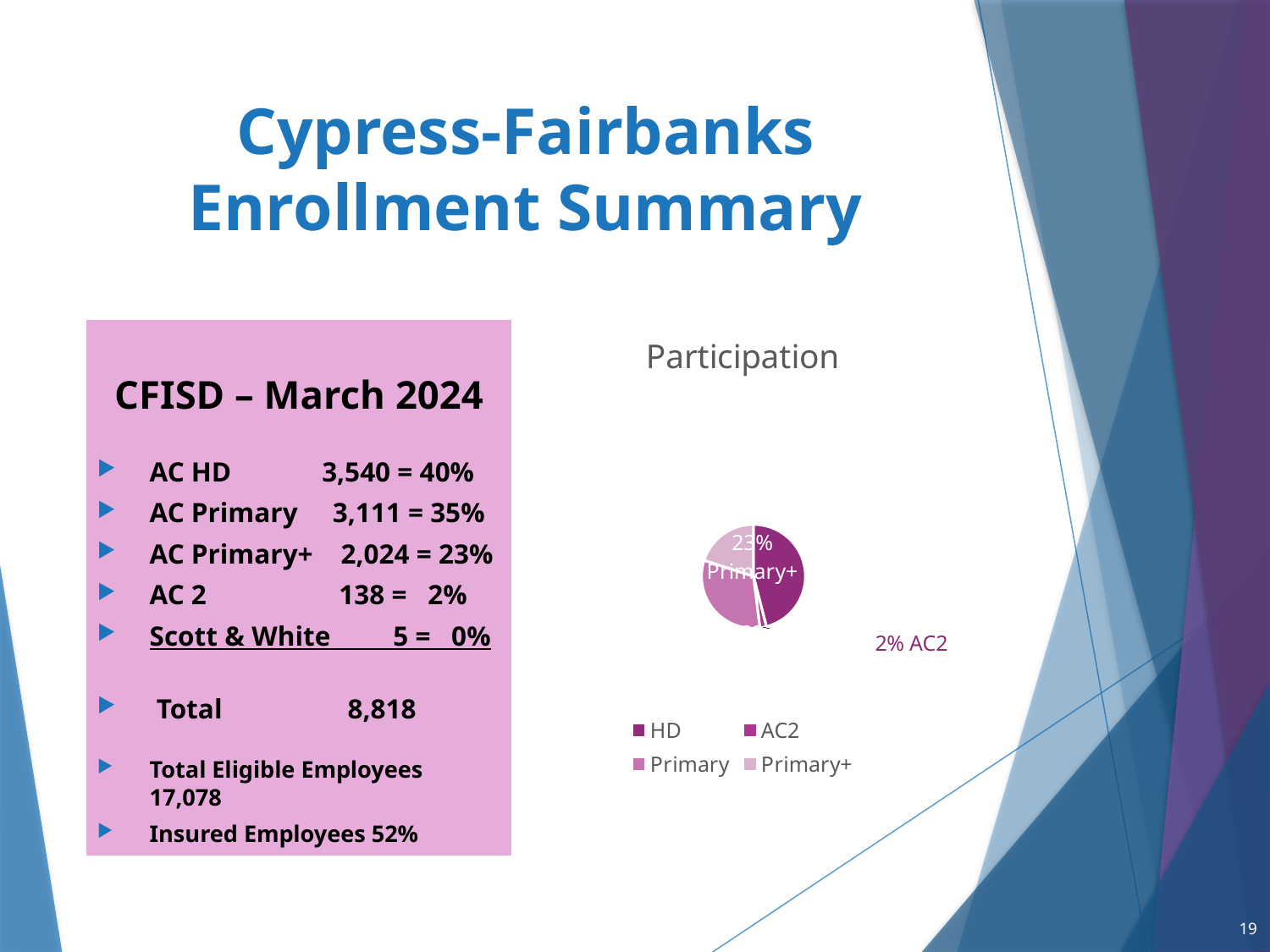
Which legend entries are listed for the Participation chart? HD, AC2, Primary, Primary+ In the Participation chart, which is larger: the Primary+ slice or the AC2 slice? Primary+ What share of the Participation pie is labelled for Primary+? 23% What is the difference between the labelled shares of Primary+ and AC2 in the Participation chart? 21% How many series does the legend of the Participation chart list? 4 Which slice of the Participation pie is the smallest? AC2 What share of the Participation pie is labelled for AC2? 2% What is the title of the chart on the slide? Participation How many slices does the Participation pie chart have? 4 What kind of chart is the Participation chart? pie chart